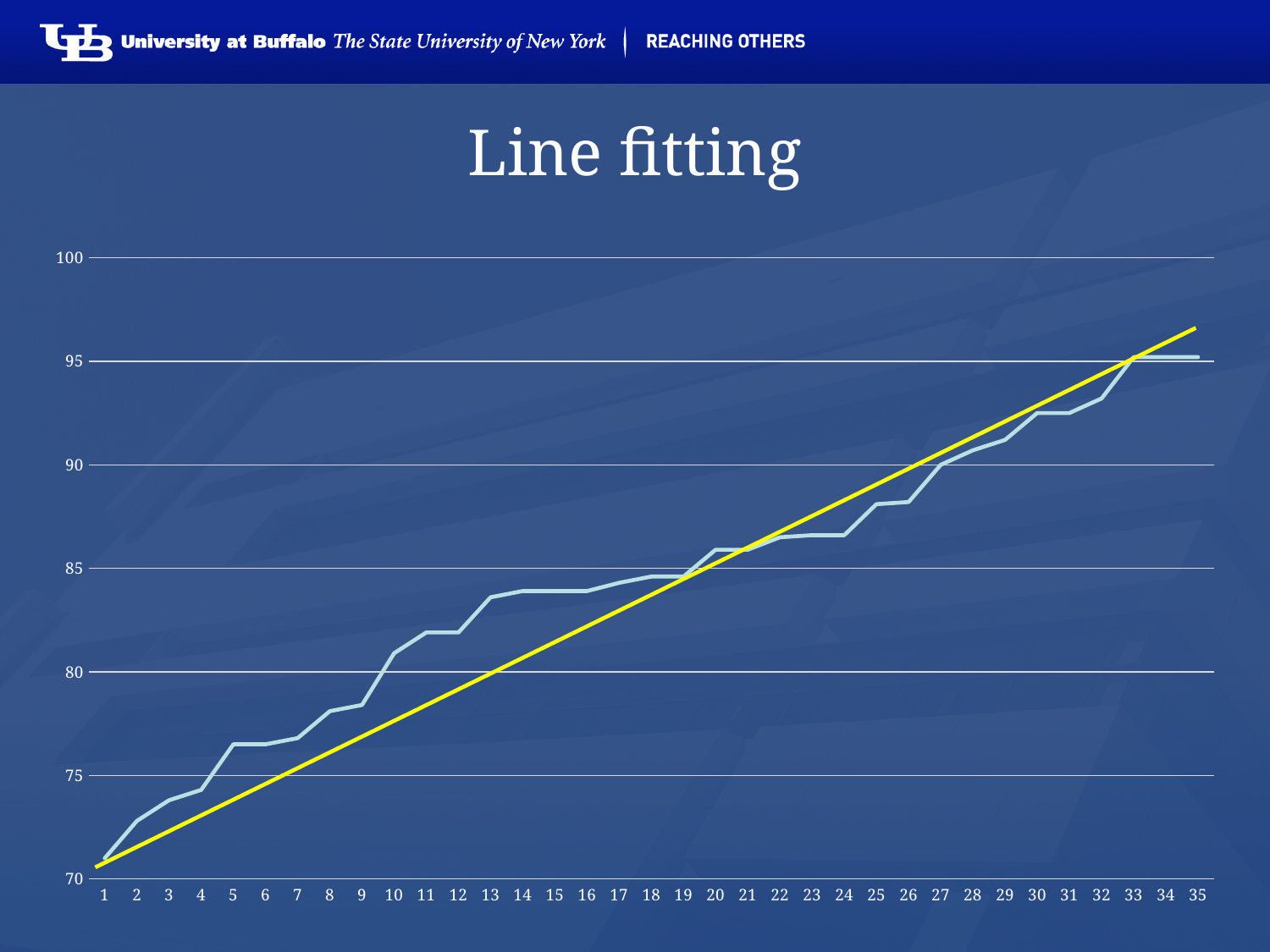
Is the value of the light blue line at x = 13 greater or less than 80? greater How many points are plotted along the x axis of the chart? 35 Is the value of the light blue line at x = 30 greater or less than 90? greater Is the value of the light blue line at x = 3 greater or less than 75? less Do the values of the light blue line rise or fall as the x axis goes from 1 to 35? rise What kind of chart is shown on the slide? line chart At which x value is the light blue line at its lowest? 1 Which has the larger value on the light blue line, x = 5 or x = 10? x = 10 What is the title of the chart? Line fitting What colour is the straight fitted line on the chart? yellow